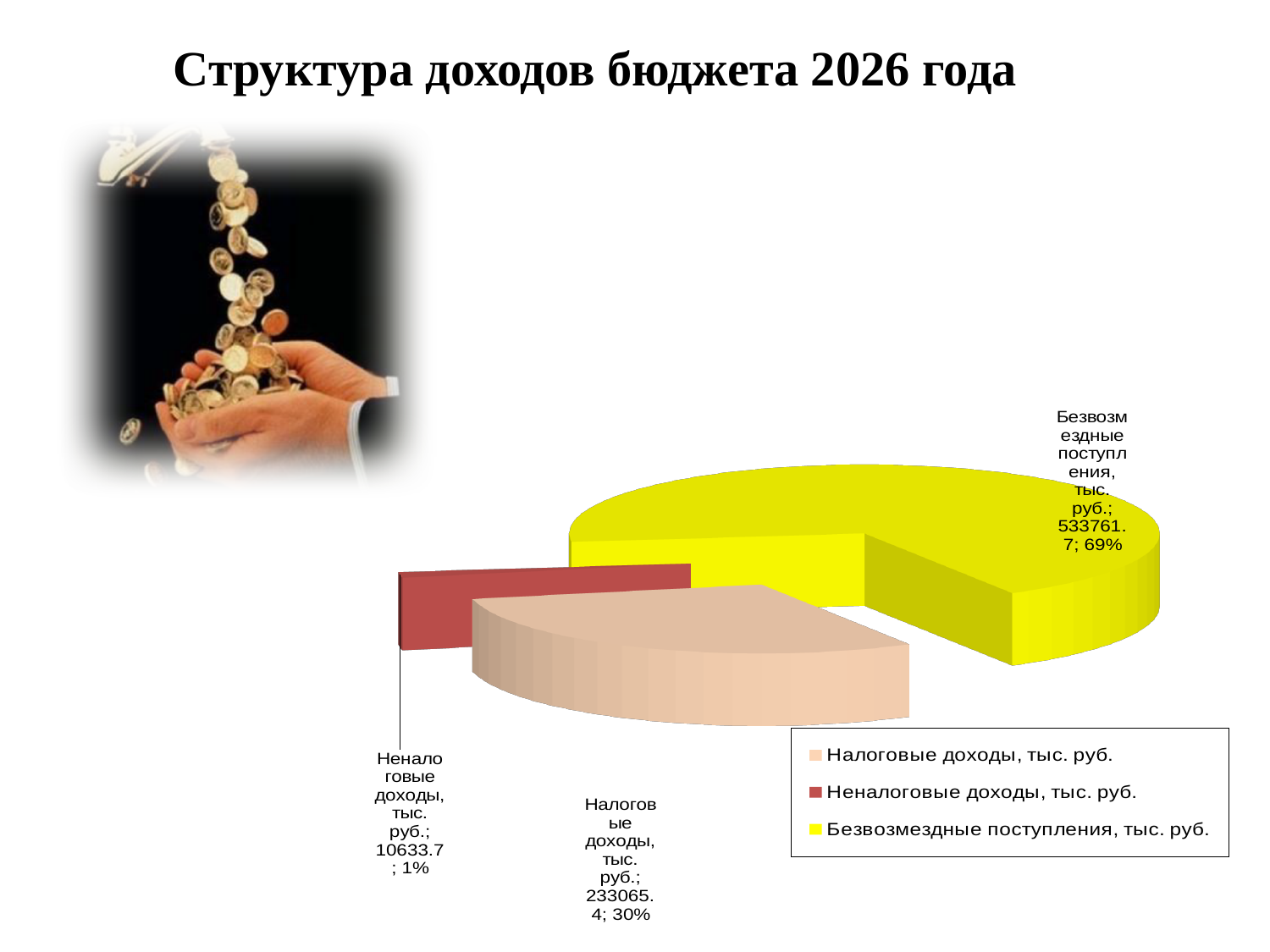
What type of chart is shown on the slide? Pie chart Which category has the largest slice of the pie? Безвозмездные поступления, тыс. руб. What is the title of the slide? Структура доходов бюджета 2026 года What share of the pie does Безвозмездные поступления represent? 69% What is the value for Безвозмездные поступления, тыс. руб.? 533761.7 What is the value for Налоговые доходы, тыс. руб.? 233065.4 What is the value for Неналоговые доходы, тыс. руб.? 10633.7 How many categories does the pie chart have? 3 What is the difference between the values for Безвозмездные поступления and Налоговые доходы? 300696.3 Which is larger: Налоговые доходы or Неналоговые доходы? Налоговые доходы What share of the pie does Налоговые доходы represent? 30% Which category has the smallest slice of the pie? Неналоговые доходы, тыс. руб.